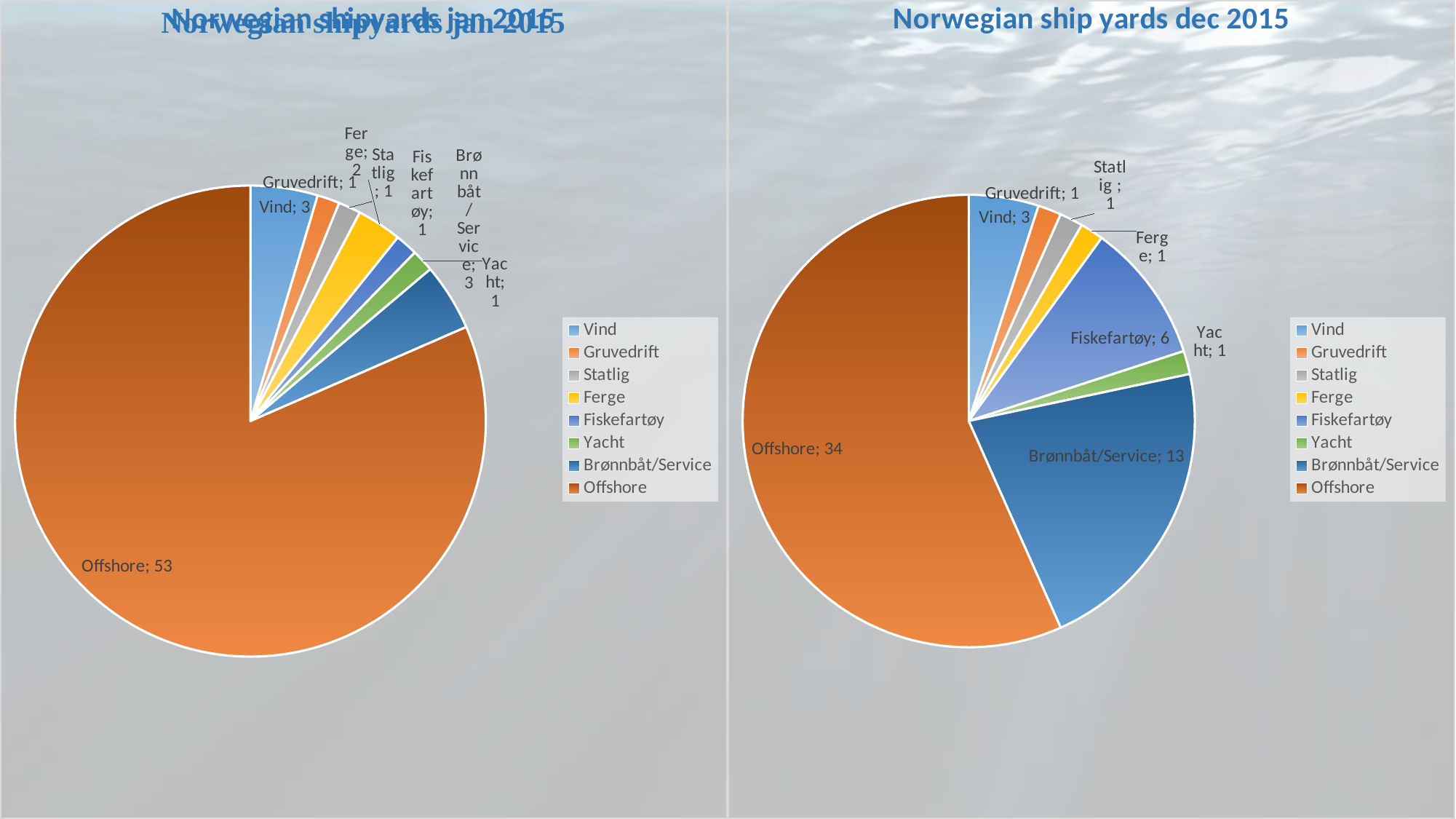
In the 'Norwegian ship yards dec 2015' chart, what is the difference between Fiskefartøy and Vind? 3 In the 'Norwegian ship yards dec 2015' chart, what is the value for Brønnbåt/Service? 13 In the 'Norwegian shipyards jan 2015' chart, what is the value for Brønnbåt/Service? 3 In the 'Norwegian shipyards jan 2015' chart, what is the value for Vind? 3 How many series does the legend of the 'Norwegian ship yards dec 2015' chart list? 8 In the 'Norwegian ship yards dec 2015' chart, what is the difference between Offshore and Brønnbåt/Service? 21 What kind of chart is the 'Norwegian shipyards jan 2015' chart? Pie chart In the 'Norwegian shipyards jan 2015' chart, what is the value for Offshore? 53 In the 'Norwegian ship yards dec 2015' chart, what is the value for Fiskefartøy? 6 Which colour represents Offshore in the legend of the 'Norwegian ship yards dec 2015' chart? Orange In the 'Norwegian ship yards dec 2015' chart, which category has the largest slice? Offshore In the 'Norwegian shipyards jan 2015' chart, which is larger, Ferge or Gruvedrift? Ferge